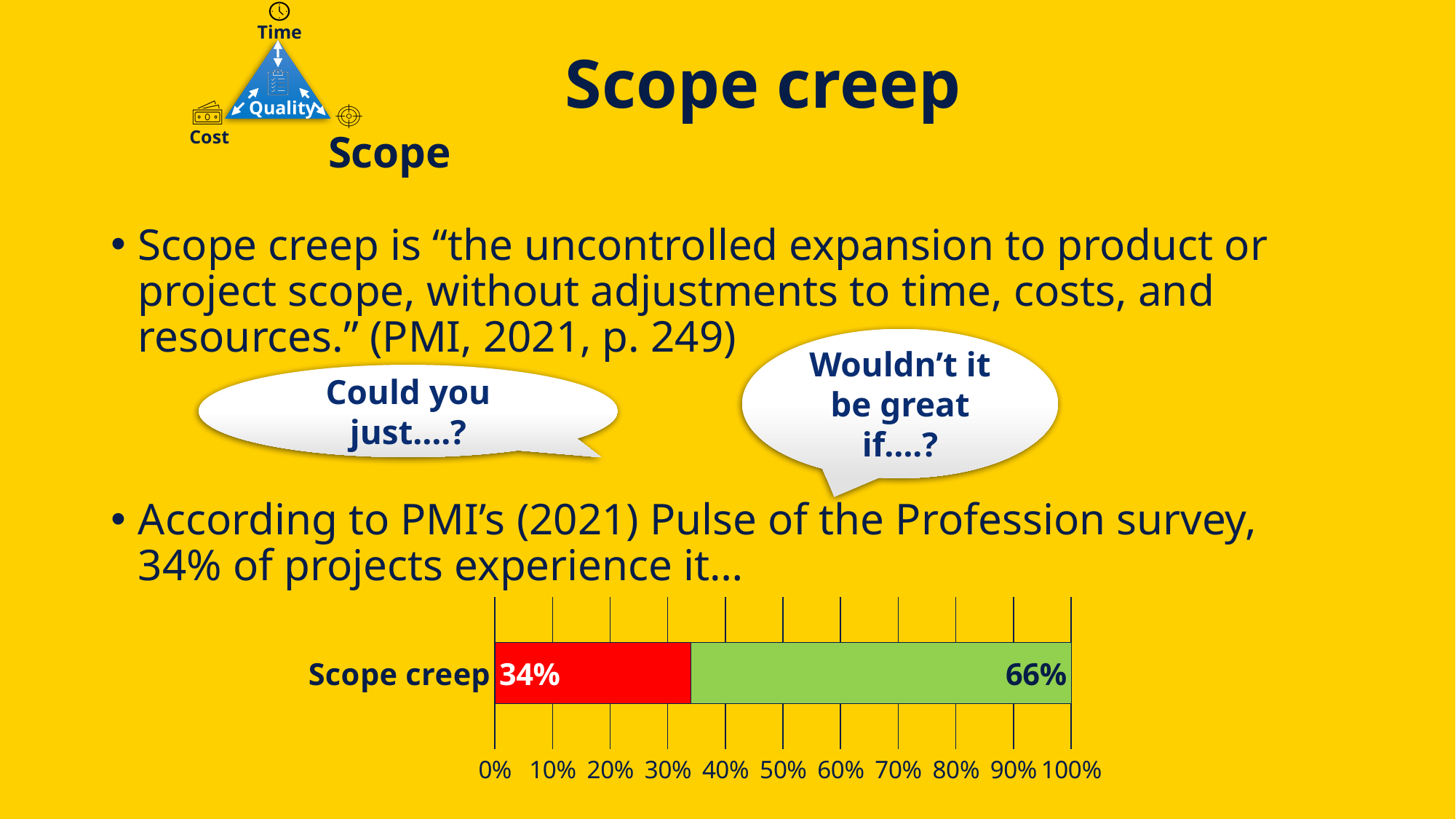
What value is shown on the green segment of the Scope creep bar? 66% Is the green segment of the Scope creep bar greater or less than 60%? greater Is the red segment of the Scope creep bar greater or less than 50%? less What value is shown on the red segment of the Scope creep bar? 34% What is the total of the two segments in the Scope creep bar? 100% What is the label of the category plotted in the chart? Scope creep Which segment of the Scope creep bar is larger, the red one or the green one? the green one How many categories are plotted in the chart? 1 What is the difference between the green segment value and the red segment value in the Scope creep bar? 32% What kind of chart is shown at the bottom of the slide? bar chart What is the highest value shown on the chart's horizontal axis? 100%